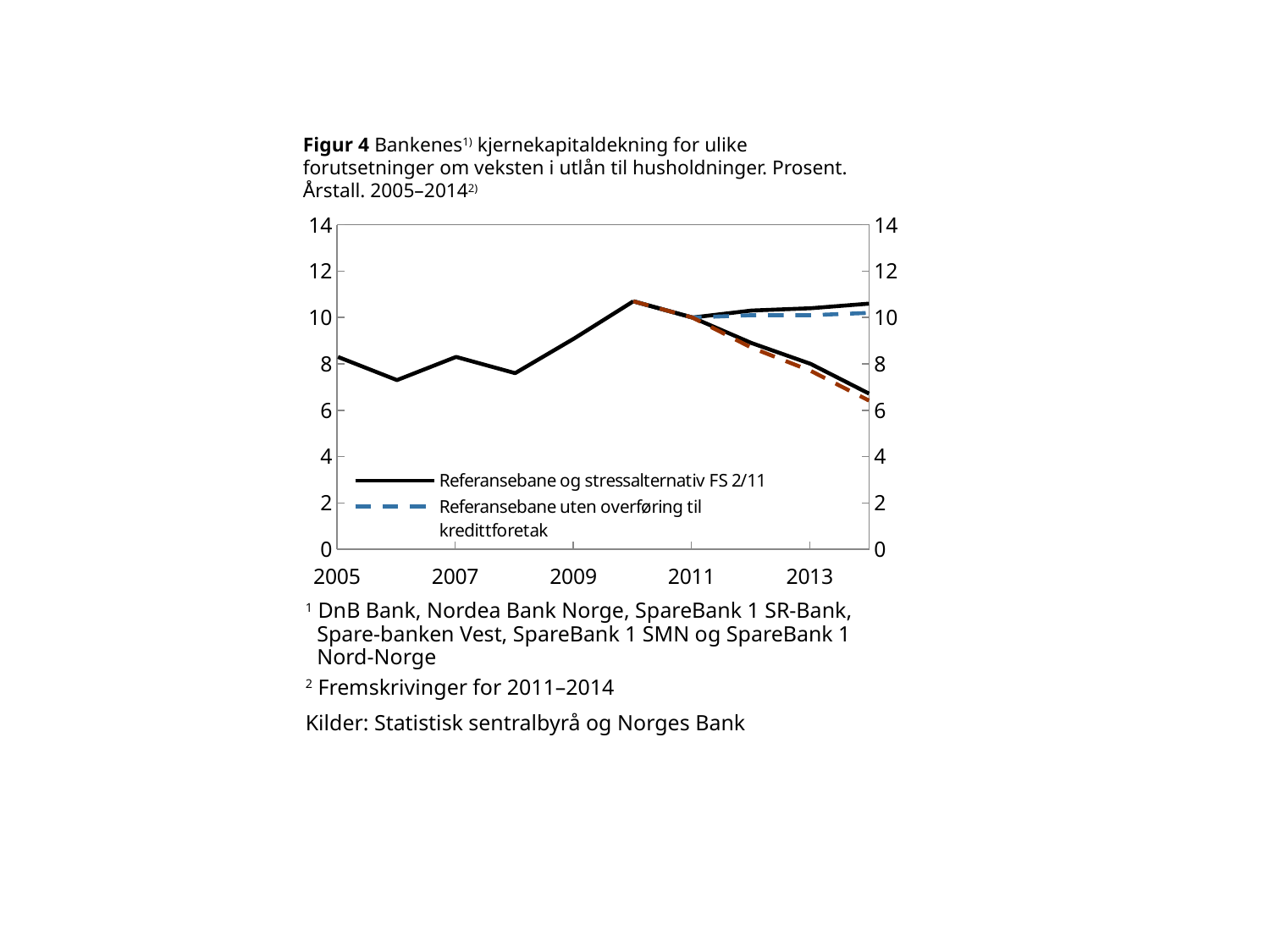
Does the lower solid black line rise or fall between 2011 and 2014? Fall Does the solid black line rise or fall between 2008 and 2010? Rise Is the value of the solid black line in 2006 greater or less than 8? less Is the value of the blue dashed line in 2014 greater or less than 8? greater Which years does the chart title say the data covers? 2005–2014 Is the value of the solid black line in 2005 greater or less than 6? greater What kind of chart is shown in Figur 4? Line chart What is the highest value shown on the y axis? 14 How many series does the legend list? 2 How many year labels are shown on the x axis? 5